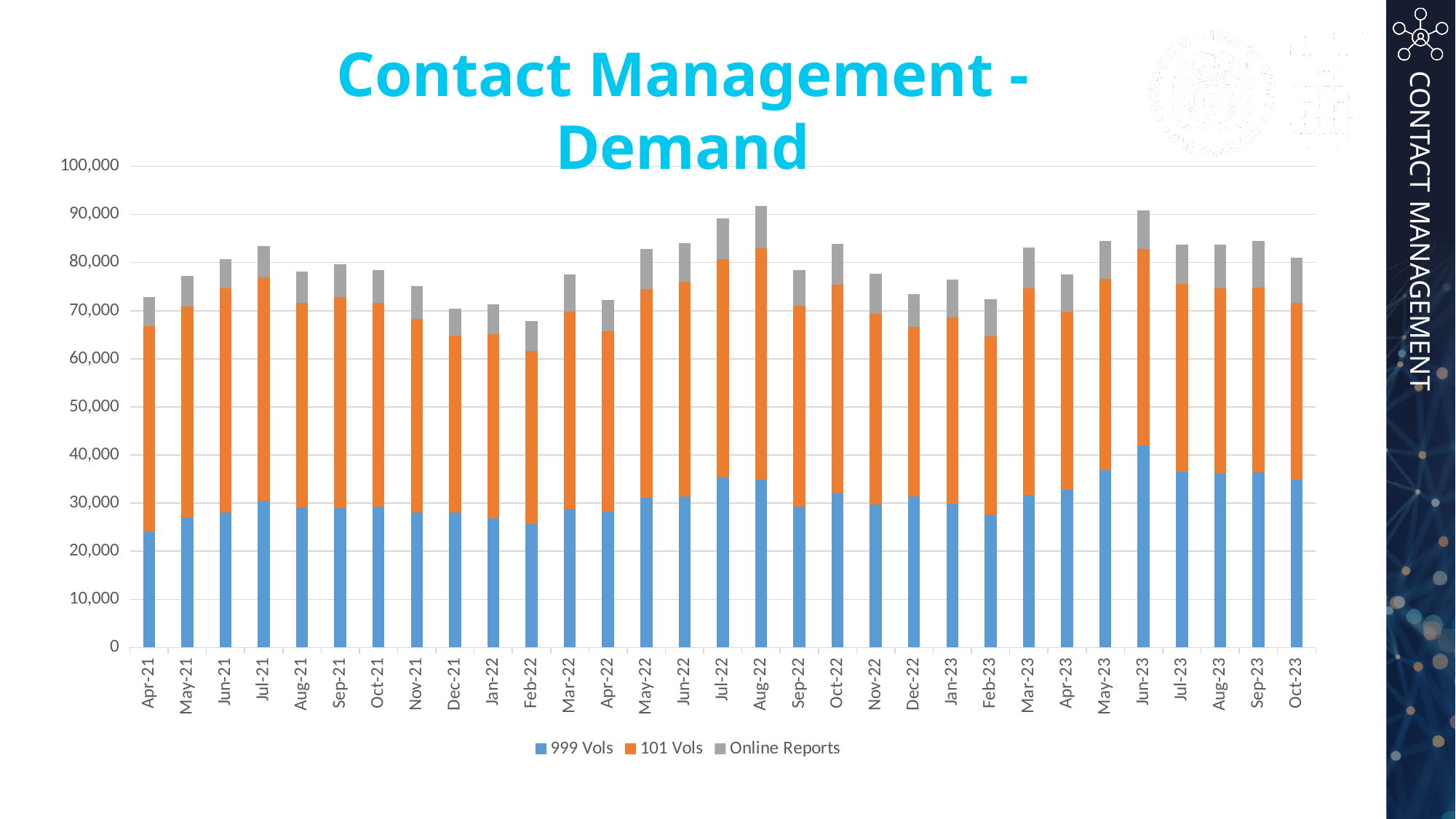
Do the total stacked bars rise or fall from Apr-21 to Jul-21? rise Which has the larger total stacked bar, Feb-22 or Aug-22? Aug-22 How many series does the legend list? 3 How many months are plotted along the x axis? 31 What kind of chart is shown on the slide? Stacked bar chart Is the 999 Vols value for Jun-23 greater or less than 40,000? greater Which month has the highest 999 Vols value? Jun-23 Which month has the lowest total stacked bar? Feb-22 Is the total stacked bar for Aug-22 greater or less than 90,000? greater Which month has the lowest 999 Vols value? Apr-21 Is the total stacked bar for Feb-22 greater or less than 70,000? less Which series is shown in grey in the legend? Online Reports